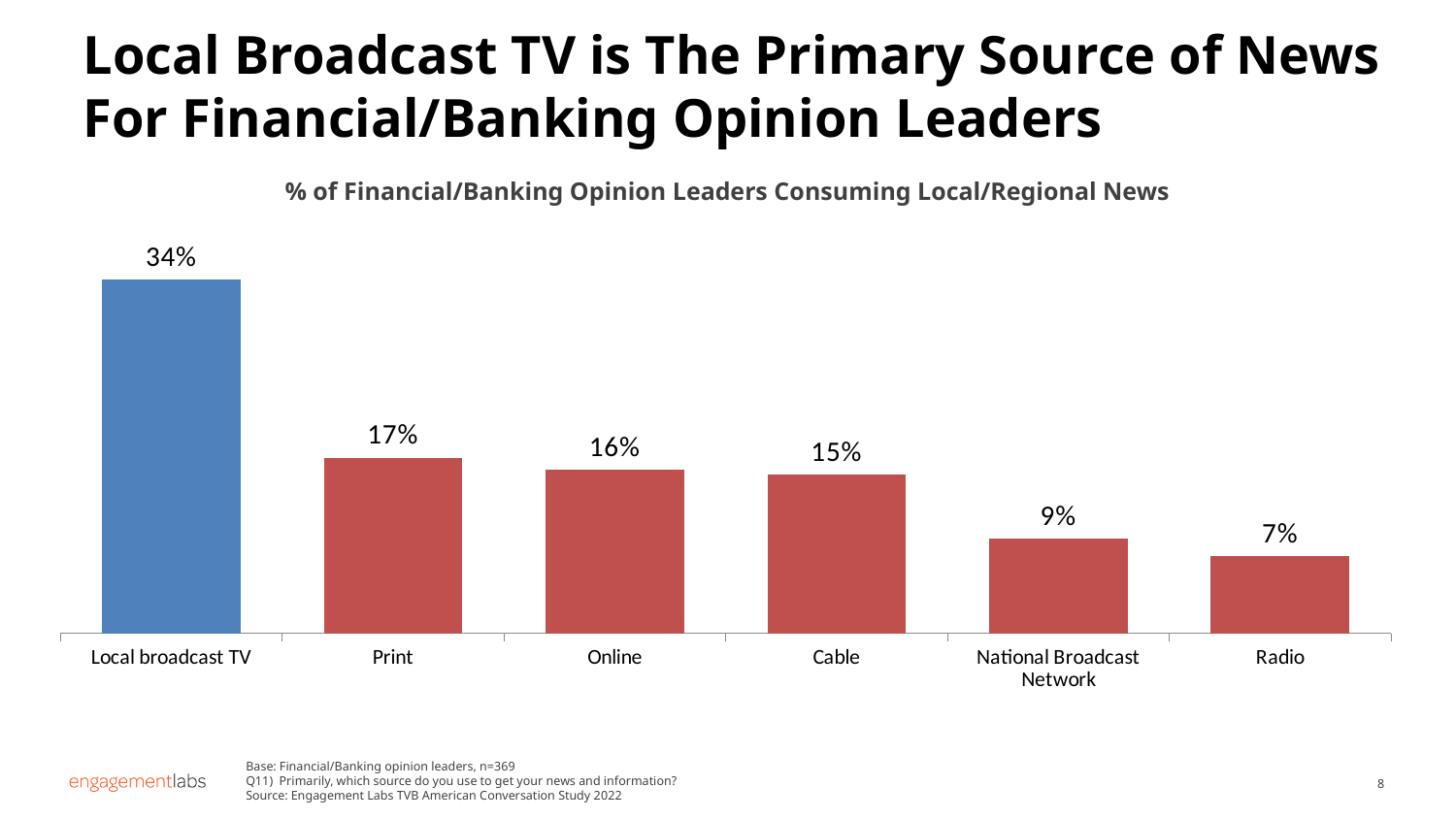
Which news source has the lowest percentage? Radio What type of chart is shown on the slide? Bar chart What is the difference in percentage points between Local broadcast TV and Print? 17 What percentage of Financial/Banking opinion leaders consume local/regional news via Local broadcast TV? 34% Which news source has the highest percentage? Local broadcast TV What is the value shown for Print? 17% What is the difference in percentage points between Cable and Radio? 8 Which has a higher value, National Broadcast Network or Radio? National Broadcast Network What is the value shown for National Broadcast Network? 9% How many news sources are shown in the chart? 6 What is the title of the chart? % of Financial/Banking Opinion Leaders Consuming Local/Regional News Which has a higher value, Online or Cable? Online